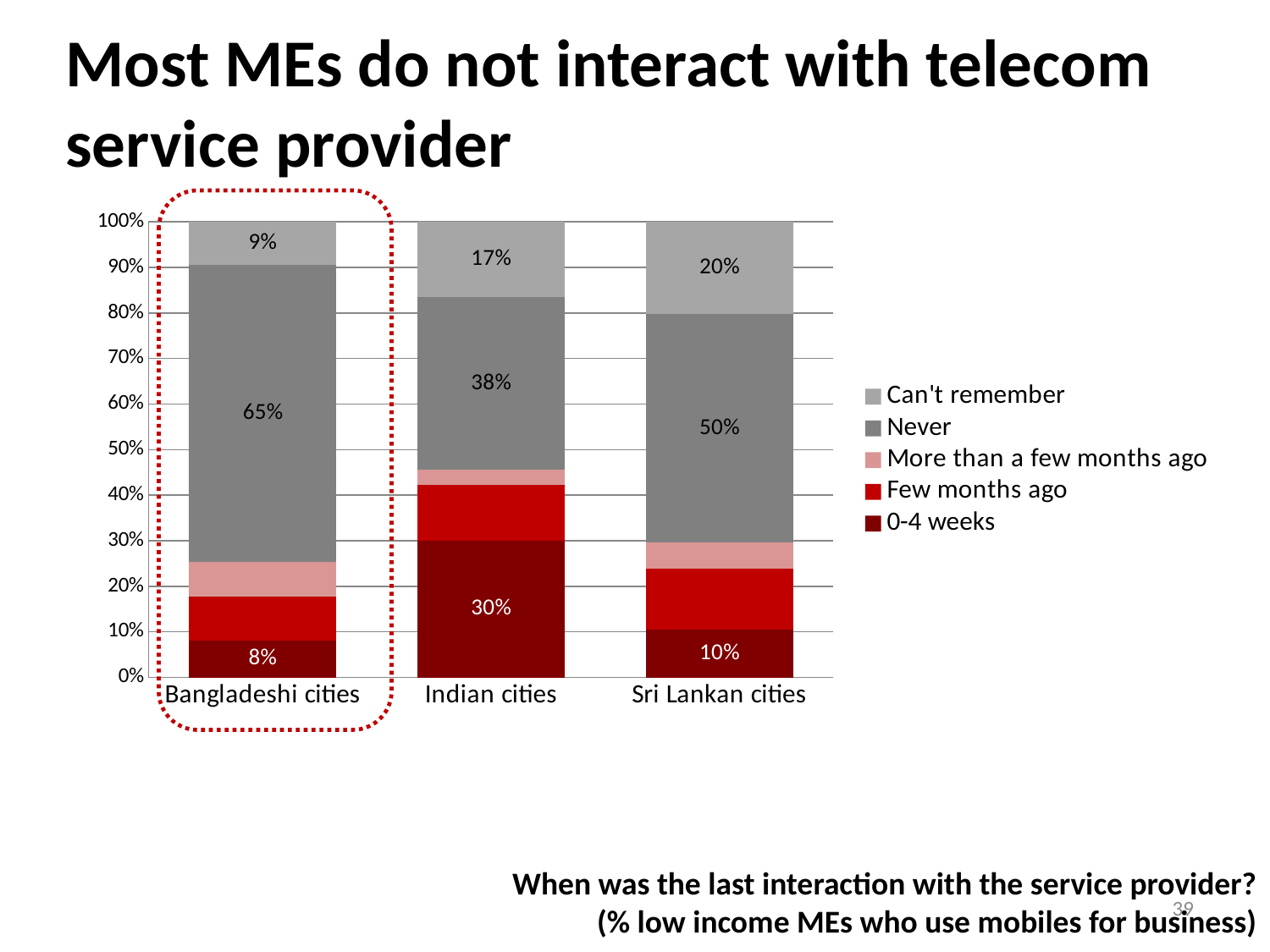
What kind of chart is shown on the slide? Stacked bar chart What percentage of MEs in Bangladeshi cities answered 'Never'? 65% What is the value for 'Never' in Sri Lankan cities? 50% How many series does the legend list? 5 What is the difference in percentage points between the 'Never' share in Bangladeshi cities and in Sri Lankan cities? 15 percentage points What share of MEs in Sri Lankan cities answered 'Can't remember'? 20% Which city group has the highest share of 'Never' responses? Bangladeshi cities Is the value for 'More than a few months ago' in Sri Lankan cities greater or less than 10%? less How many city groups are shown on the x axis? 3 Which is larger: the 'Can't remember' share in Indian cities or in Sri Lankan cities? Sri Lankan cities Which city group has the lowest share of '0-4 weeks' responses? Bangladeshi cities What is the value for '0-4 weeks' in Indian cities? 30%